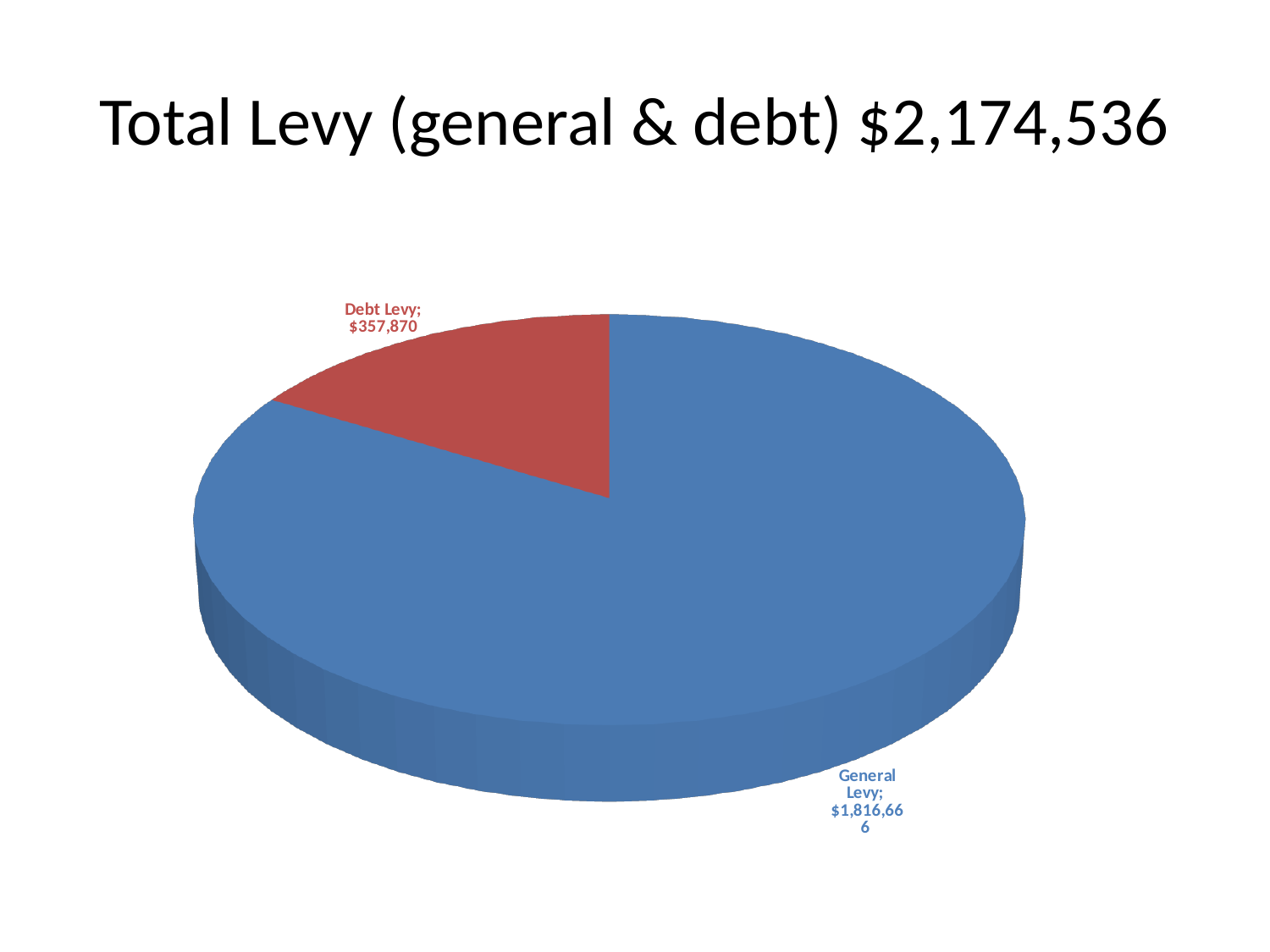
What is the total of the two slices in the pie chart? $2,174,536 Which slice is the smallest? Debt Levy What is the value of the General Levy slice? $1,816,666 Which slice is the largest? General Levy What is the difference between the General Levy and the Debt Levy? $1,458,796 What is the title of the chart? Total Levy (general & debt) $2,174,536 Which is larger, the General Levy or the Debt Levy? General Levy What is the value of the Debt Levy slice? $357,870 What kind of chart is shown on the slide? Pie chart How many slices does the pie chart have? 2